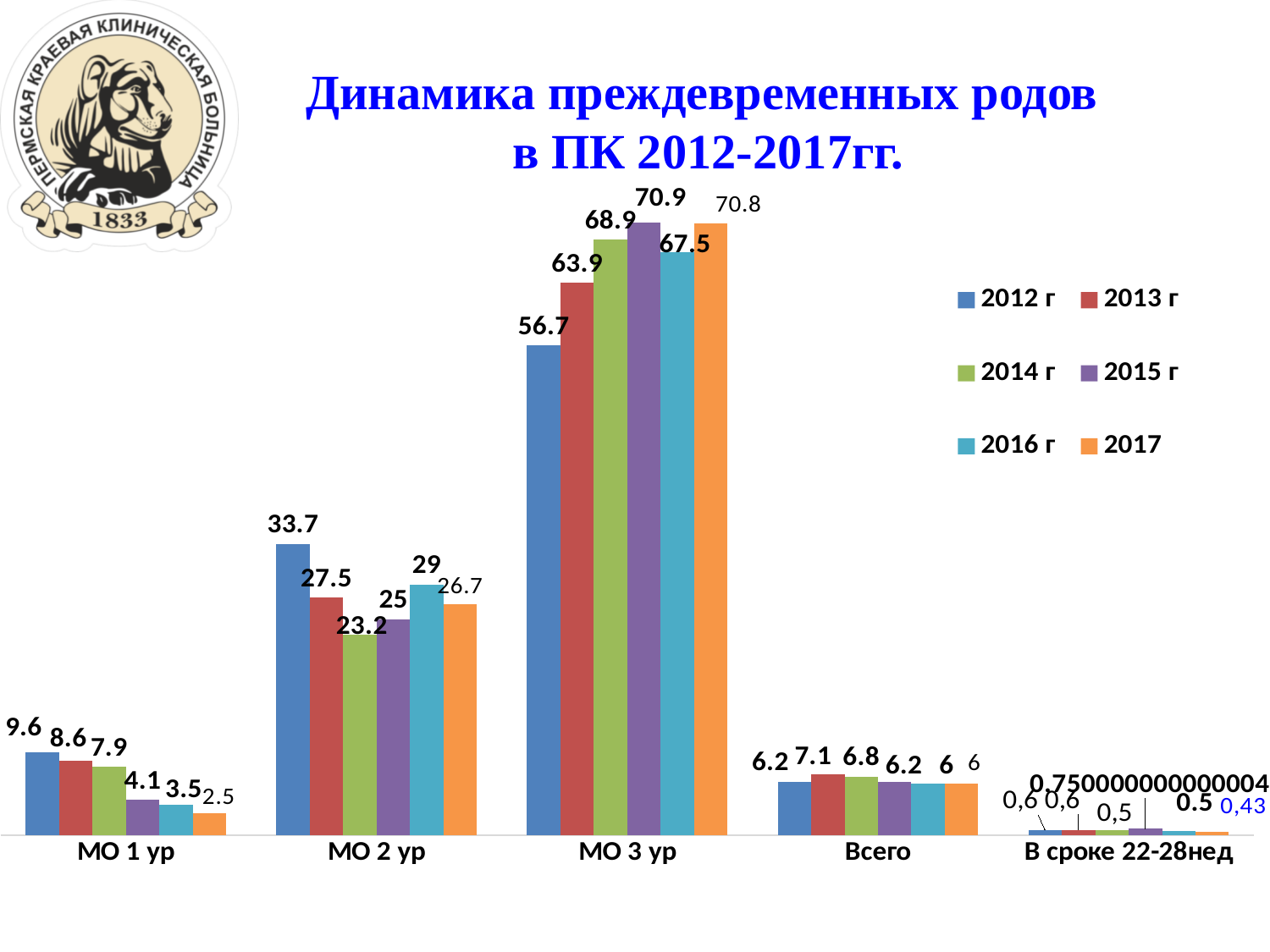
Do the values in the МО 1 ур category rise or fall from 2012 г to 2017? fall What is the difference between the 2012 г and 2017 values in the МО 3 ур category? 14.1 How many categories are shown on the x axis? 5 How many series does the legend list? 6 What is the value for 2017 in the МО 1 ур category? 2.5 What type of chart is shown on the slide? bar chart Which is larger in the МО 2 ур category: the value for 2013 г or the value for 2016 г? 2016 г What is the value for 2015 г in the МО 3 ур category? 70.9 What is the value for 2012 г in the МО 2 ур category? 33.7 What is the title of the chart? Динамика преждевременных родов в ПК 2012-2017гг. Which year has the lowest value in the МО 1 ур category? 2017 Which year has the highest value in the МО 3 ур category? 2015 г